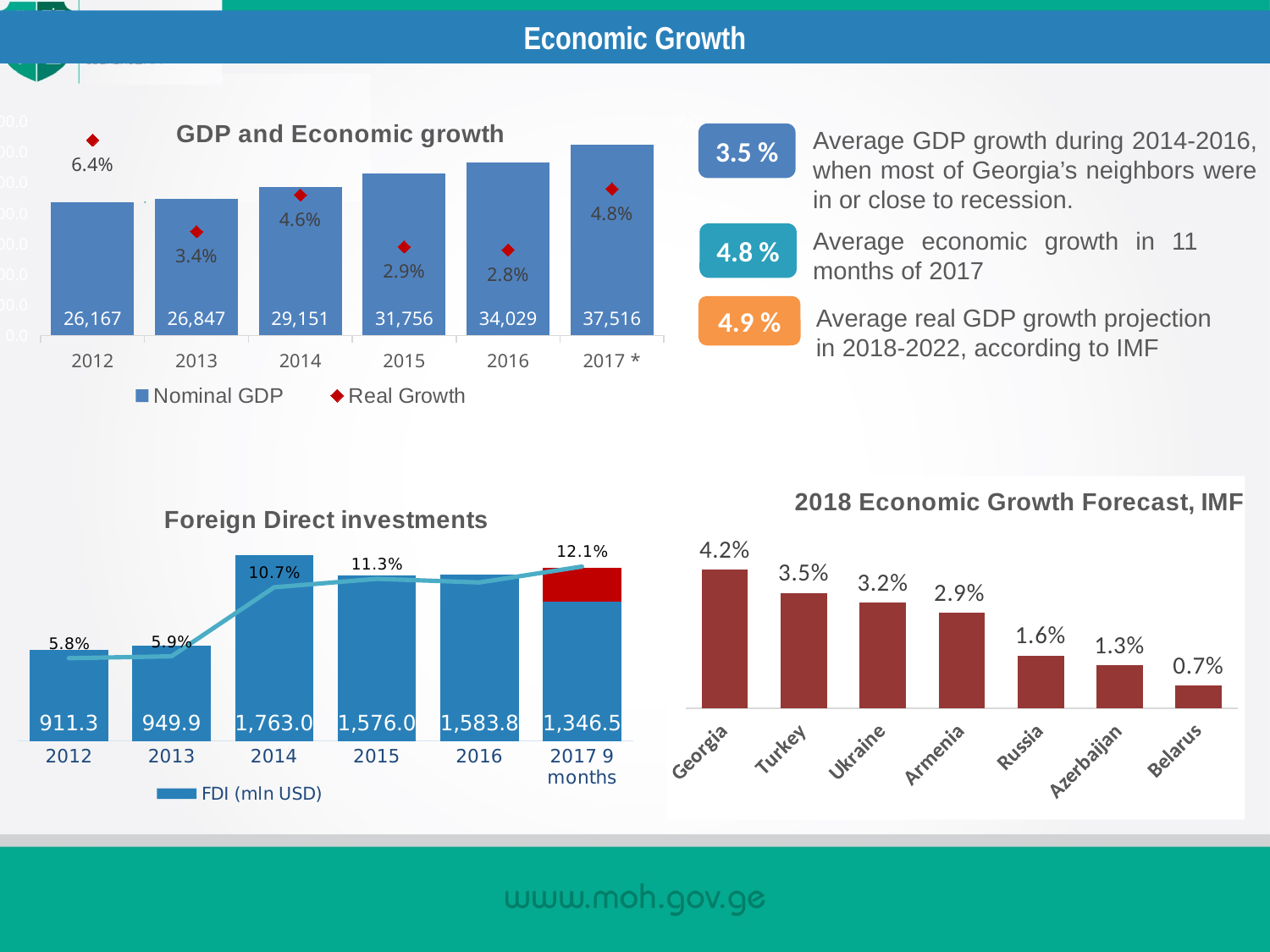
In the 'Foreign Direct investments' chart, what is the FDI (mln USD) value for 2014? 1,763.0 In the 'Foreign Direct investments' chart, what is the percentage label shown for 2017 9 months? 12.1% In the 'GDP and Economic growth' chart, what is the Nominal GDP value for 2015? 31,756 In the 'GDP and Economic growth' chart, what is the difference in Nominal GDP between 2017 * and 2016? 3,487 In the 'GDP and Economic growth' chart, what is the Real Growth value for 2012? 6.4% In the 'Foreign Direct investments' chart, which year has the highest FDI (mln USD) value? 2014 In the '2018 Economic Growth Forecast, IMF' chart, which country has the lowest forecast? Belarus In the '2018 Economic Growth Forecast, IMF' chart, what is the forecast for Armenia? 2.9% In the 'GDP and Economic growth' chart, which year has the lowest Real Growth? 2016 How many series does the legend of the 'GDP and Economic growth' chart list? 2 In the 'Foreign Direct investments' chart, is the FDI value for 2013 larger or smaller than for 2012? larger How many countries are shown in the '2018 Economic Growth Forecast, IMF' chart? 7